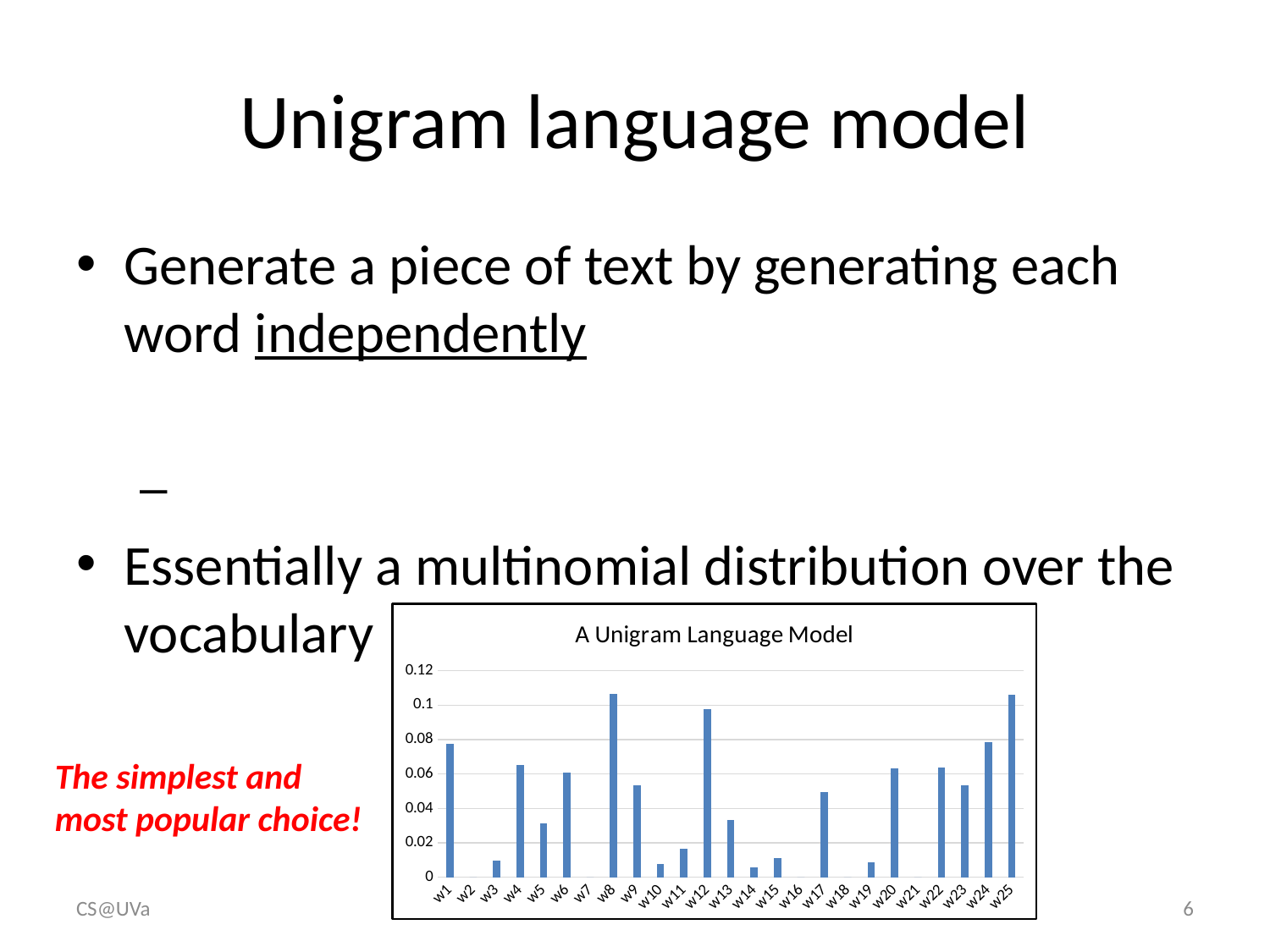
Is the value for w3 greater or less than 0.02? less What kind of chart is shown on the slide? bar chart How many word categories are shown on the x axis of the chart? 25 What is the highest value shown on the y axis of the chart? 0.12 Is the value for w5 greater or less than 0.02? greater What is the title of the chart? A Unigram Language Model Which has the larger value, w12 or w1? w12 Is the value for w8 greater or less than 0.1? greater Which has the larger value, w9 or w13? w9